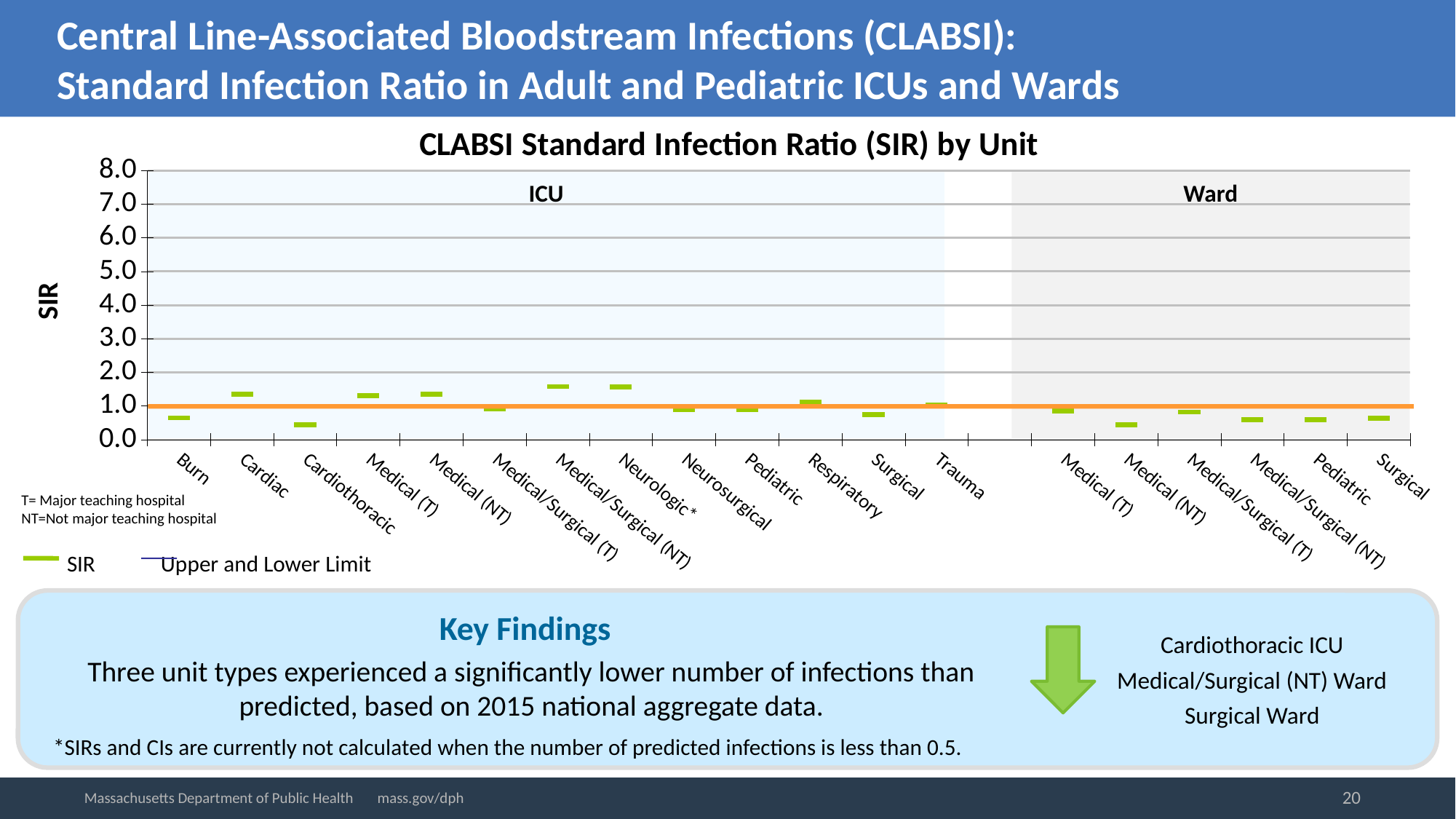
Is the SIR value for the Cardiac ICU greater or less than 1.0? greater Is the SIR value for the Medical (NT) Ward greater or less than 1.0? less How many series does the chart legend list? 2 Is the SIR value for the Cardiothoracic ICU greater or less than 1.0? less How many unit categories are labelled on the x axis in the Ward section? 6 How many unit categories are labelled on the x axis in the ICU section? 13 What is the title of the chart? CLABSI Standard Infection Ratio (SIR) by Unit Which has the higher SIR value, the Cardiac ICU or the Burn ICU? Cardiac ICU What is the label on the vertical axis of the chart? SIR